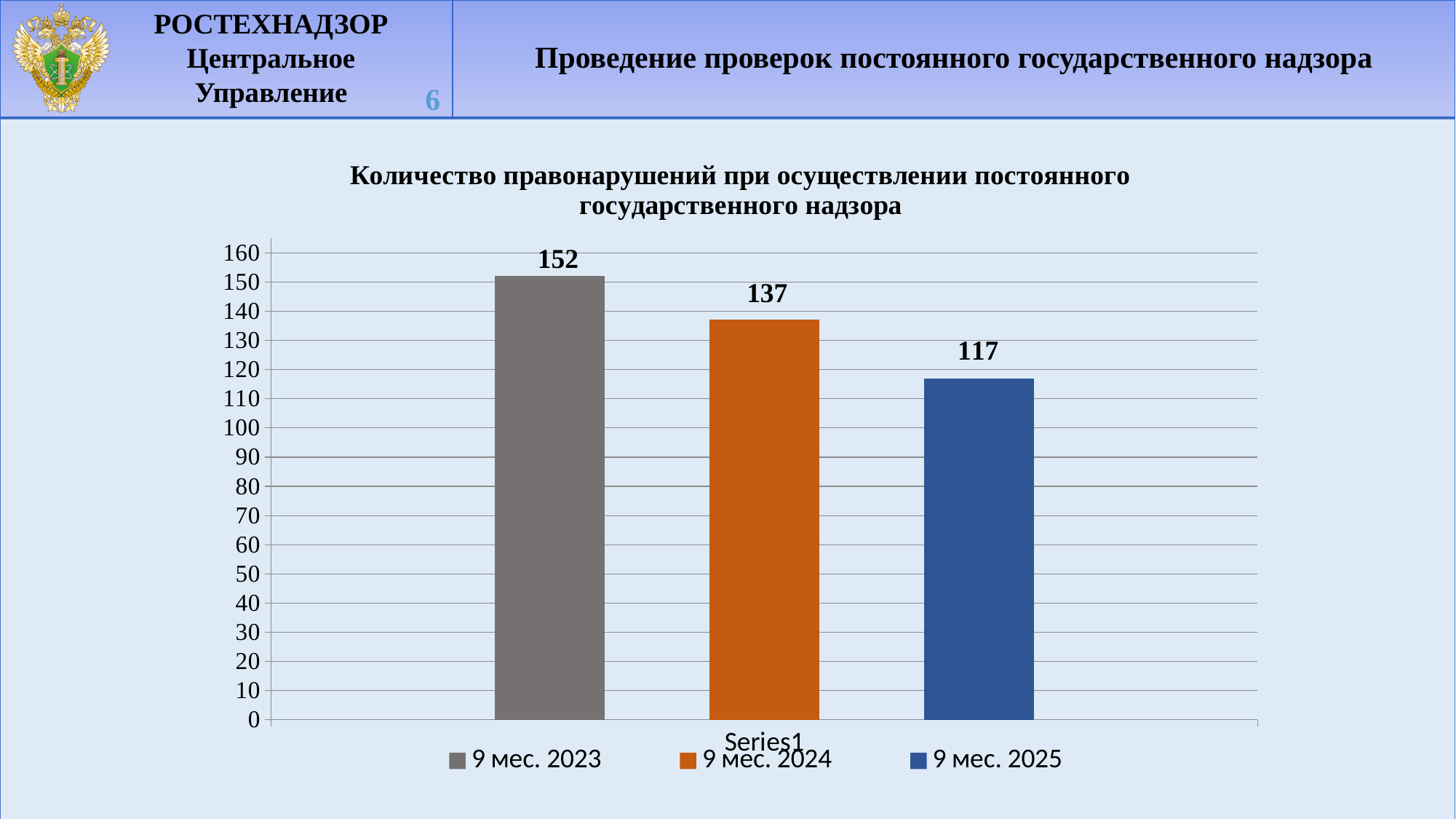
What is the value for 9 мес. 2023? 152 Which period has the lowest value? 9 мес. 2025 Which period has the highest value? 9 мес. 2023 How many series does the legend list? 3 Is the value for 9 мес. 2024 greater or less than 140? less Do the values rise or fall from 9 мес. 2023 to 9 мес. 2025? fall What is the value for 9 мес. 2024? 137 What is the value for 9 мес. 2025? 117 What is the difference between the values for 9 мес. 2024 and 9 мес. 2025? 20 Which is larger, the value for 9 мес. 2024 or the value for 9 мес. 2025? 9 мес. 2024 What kind of chart is shown on the slide? bar chart What is the difference between the values for 9 мес. 2023 and 9 мес. 2025? 35